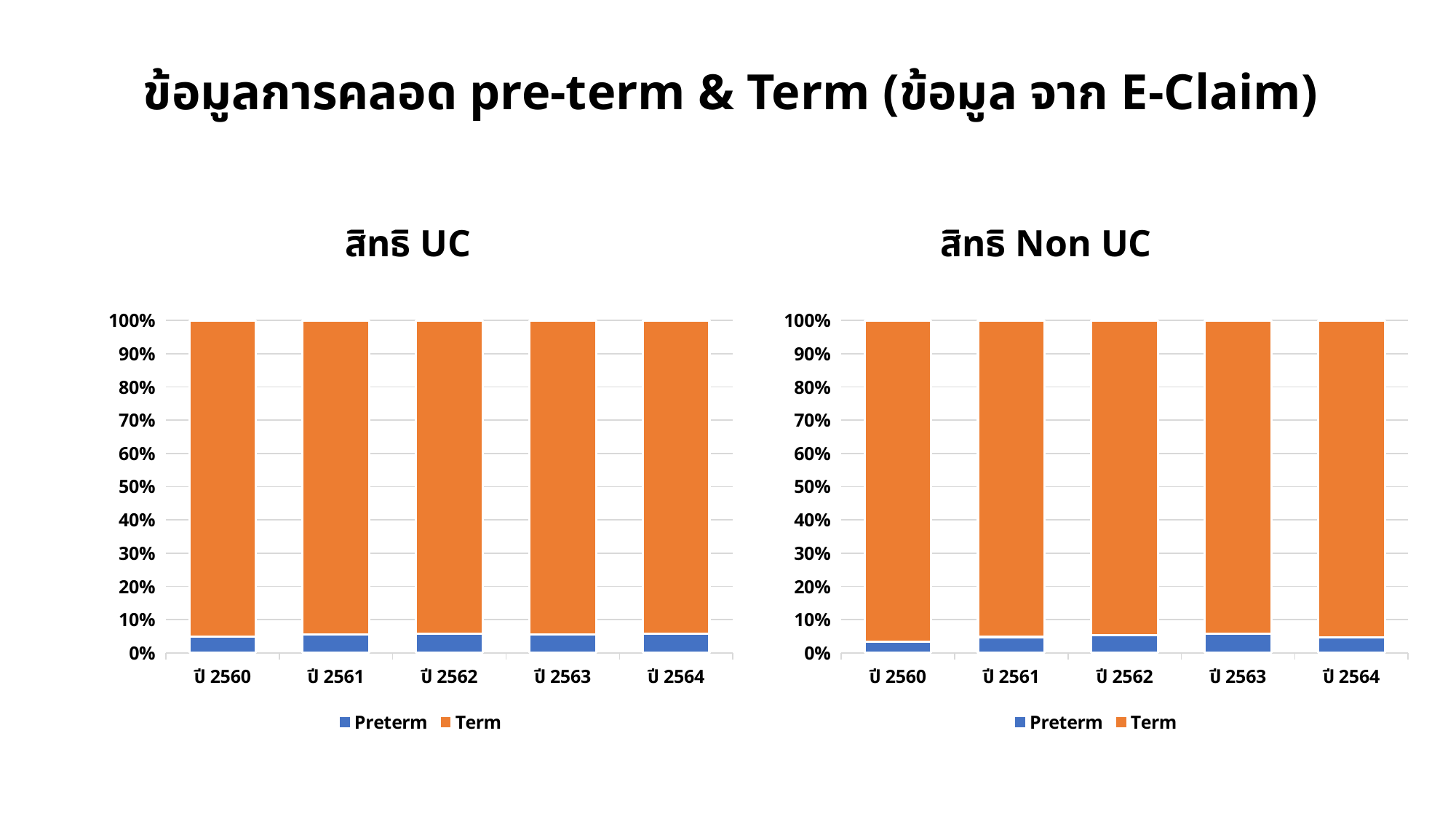
How many series does the legend of the สิทธิ Non UC chart list? 2 What are the two legend entries in the สิทธิ UC chart? Preterm, Term How many year categories are shown on the x axis of the สิทธิ UC chart? 5 What is the first year category on the x axis of the สิทธิ Non UC chart? ปี 2560 In the สิทธิ Non UC chart, is the Term share for ปี 2563 greater or less than 80%? greater What colour represents the Term series in the สิทธิ Non UC chart? orange In the สิทธิ Non UC chart, is the Preterm value for ปี 2560 greater or less than 10%? less In the สิทธิ UC chart, is the Preterm value for ปี 2562 greater or less than 10%? less In the สิทธิ UC chart, which series is larger in every year, Preterm or Term? Term In the สิทธิ Non UC chart, which is larger, the Preterm value for ปี 2560 or for ปี 2563? ปี 2563 What kind of chart is the สิทธิ UC chart? bar chart